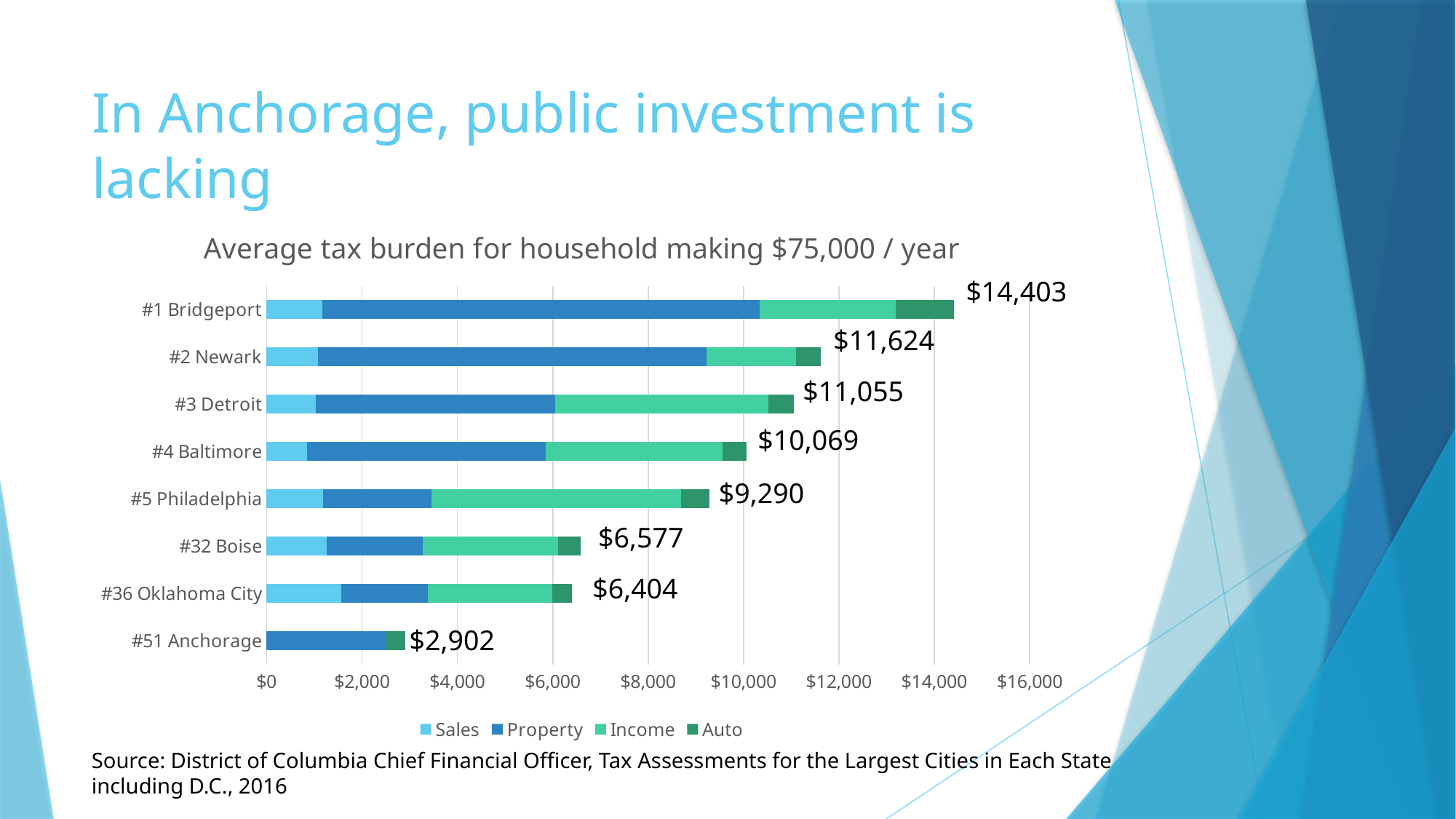
Which city has the lowest total tax burden in the chart? #51 Anchorage How many series does the legend list? 4 What is the total average tax burden shown for #1 Bridgeport? $14,403 Which city has the highest total tax burden in the chart? #1 Bridgeport What is the total average tax burden shown for #5 Philadelphia? $9,290 What is the difference between the total tax burden for #1 Bridgeport and #51 Anchorage? $11,501 What is the difference between the total tax burden for #2 Newark and #3 Detroit? $569 Is the Property segment for #1 Bridgeport greater or less than $8,000? greater How many cities are shown in the chart? 8 Which has a larger total tax burden, #32 Boise or #36 Oklahoma City? #32 Boise What kind of chart is shown on the slide? Stacked bar chart What is the total average tax burden shown for #51 Anchorage? $2,902